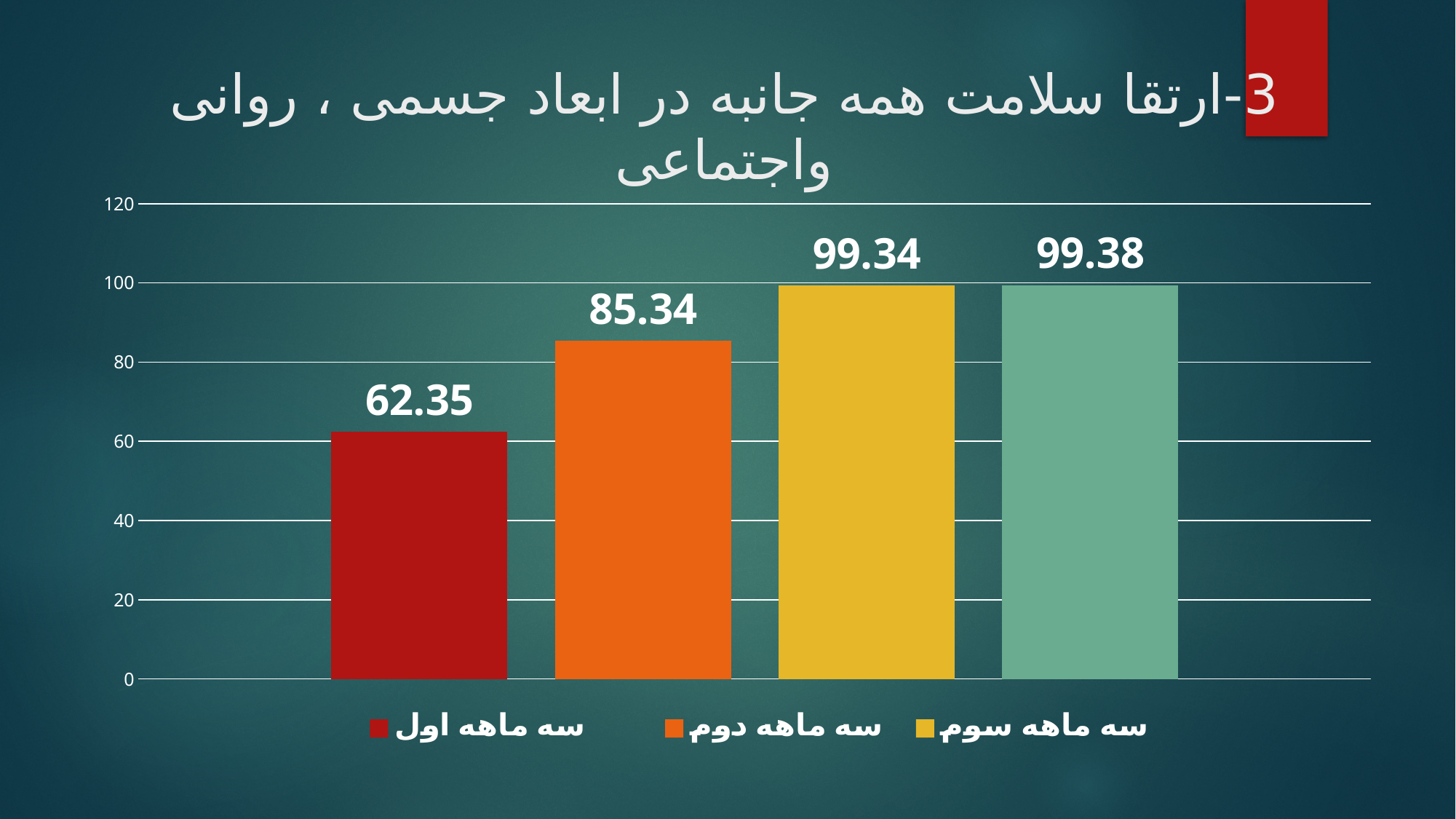
Is the value for سه ماهه اول greater or less than 80? less What is the difference between the values for سه ماهه سوم and سه ماهه دوم? 14 How many entries does the legend list? 3 What kind of chart is shown on the slide? bar chart Which is larger, the value for سه ماهه دوم or سه ماهه اول? سه ماهه دوم What is the difference between the values for سه ماهه دوم and سه ماهه اول? 22.99 How many bars are plotted on the chart? 4 What is the highest value shown on the chart? 99.38 What is the value for سه ماهه اول? 62.35 What is the value for سه ماهه سوم? 99.34 What is the value for سه ماهه دوم? 85.34 Which category has the lowest value? سه ماهه اول